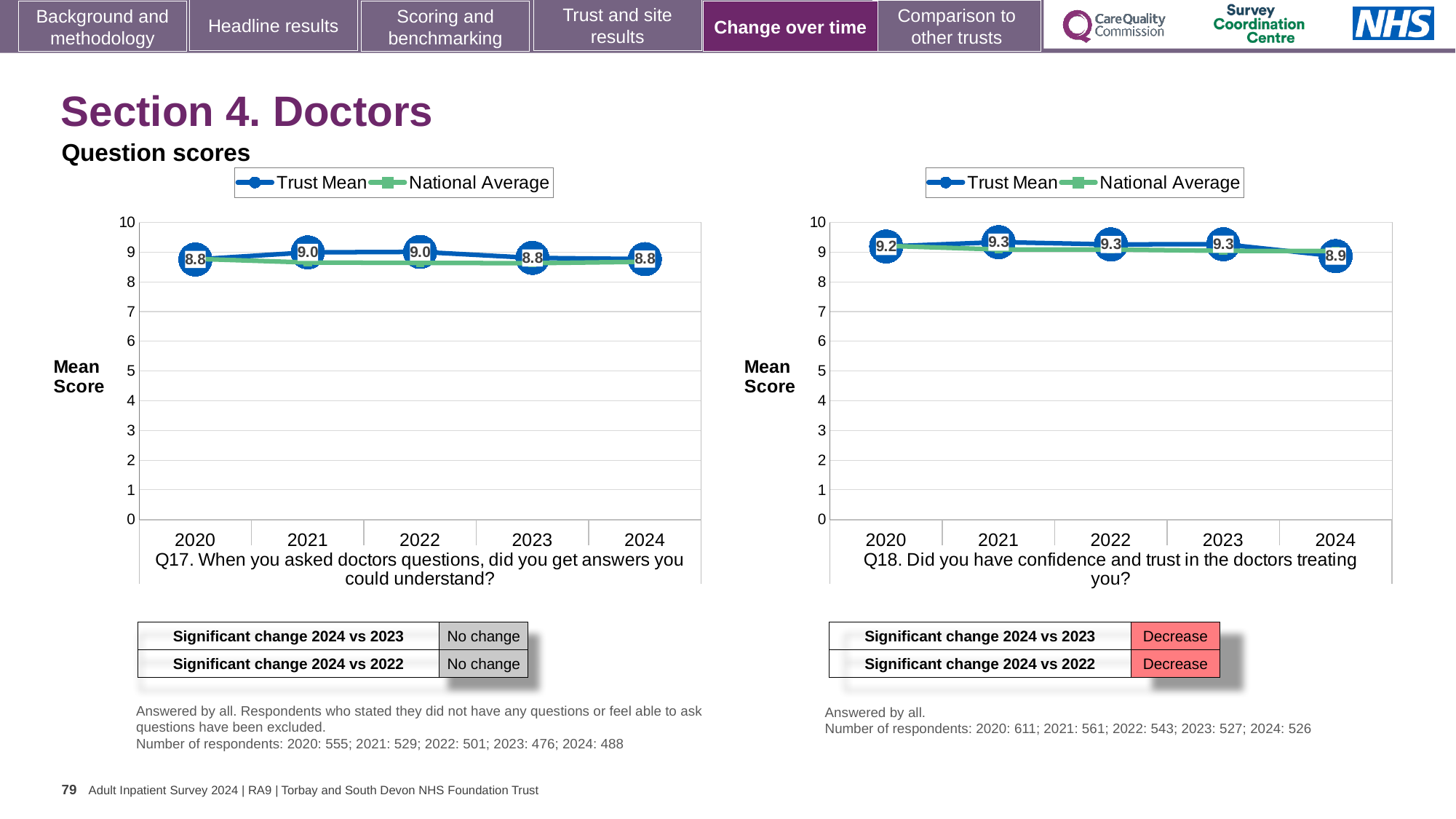
On the Q18 chart (right), how many series does the legend list? 2 On the Q18 chart (right), what is the Trust Mean score for 2024? 8.9 On the Q18 chart (right), is the National Average value for 2024 greater or less than 8? greater On the Q17 chart (left), what is the Trust Mean score for 2024? 8.8 On the Q17 chart (left), what is the Trust Mean score for 2021? 9.0 What type of chart is the Q17 chart on the left? Line chart On the Q17 chart (left), how many years are shown on the x axis? 5 On the Q17 chart (left), which series is shown in green in the legend? National Average On the Q18 chart (right), what is the difference between the Trust Mean score in 2023 and in 2024? 0.4 On the Q18 chart (right), what is the Trust Mean score for 2020? 9.2 On the Q17 chart (left), is the Trust Mean score higher in 2022 or in 2023? 2022 On the Q18 chart (right), which year has the lowest Trust Mean score? 2024